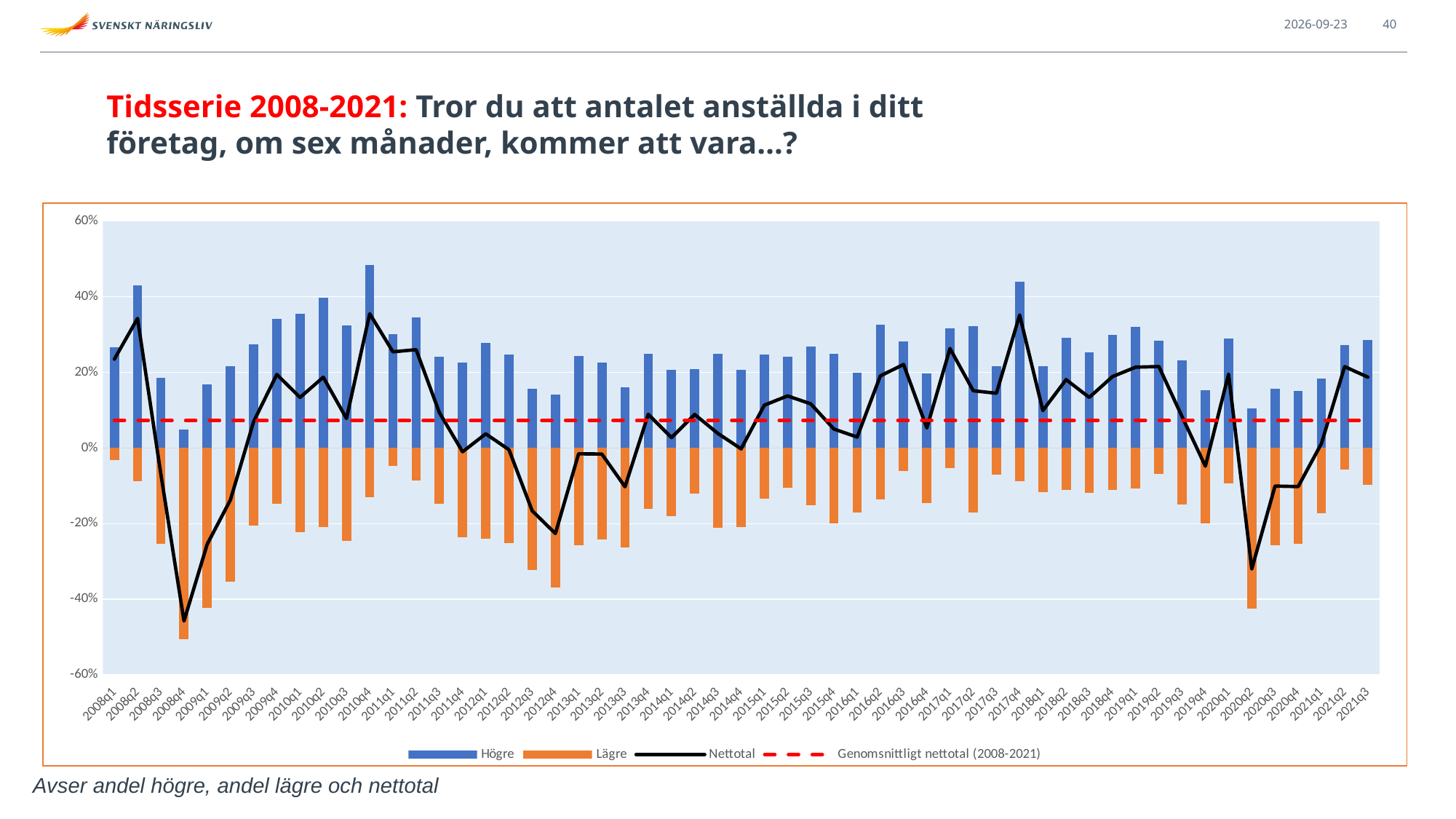
What does the red dashed line represent according to the legend? Genomsnittligt nettotal (2008-2021) Which quarter has the lowest value of the Nettotal line? 2008q4 Which quarter has the lowest (most negative) value for Lägre? 2008q4 Is the value for Lägre in 2020q2 greater or less than -40%? less Does the Nettotal line rise or fall from 2008q1 to 2008q4? fall Which quarter has the highest value for Högre? 2010q4 Is the value for Högre in 2008q4 greater or less than 20%? less How many series does the legend list? 4 What kind of chart is shown on the slide? bar chart with lines Is the value for Högre in 2010q4 greater or less than 40%? greater Which quarter has the larger Högre value, 2008q2 or 2008q3? 2008q2